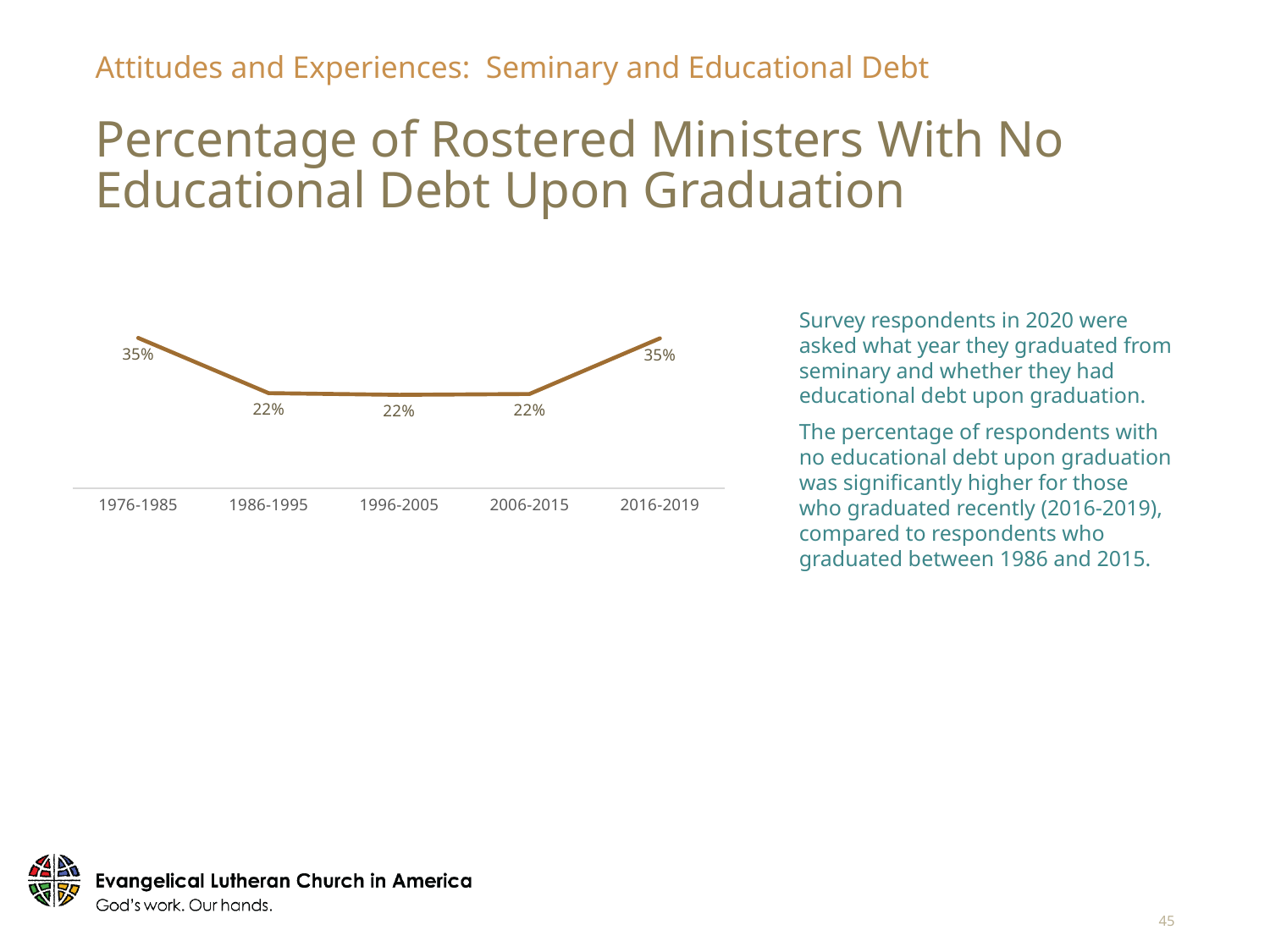
What is the highest value plotted on the chart? 35% What is the lowest value plotted on the chart? 22% Which has a higher value, 1976-1985 or 1986-1995? 1976-1985 What is the value shown for the 2016-2019 graduation period? 35% How many graduation periods are shown on the x axis? 5 What is the value shown for the 1996-2005 graduation period? 22% Does the value rise or fall from 2006-2015 to 2016-2019? Rise What kind of chart is shown on the slide? Line chart What is the difference between the value for 2016-2019 and the value for 2006-2015? 13% What is the title of the chart on the slide? Percentage of Rostered Ministers With No Educational Debt Upon Graduation What percentage of rostered ministers who graduated in 1976-1985 had no educational debt upon graduation? 35% What is the value shown for the 2006-2015 graduation period? 22%